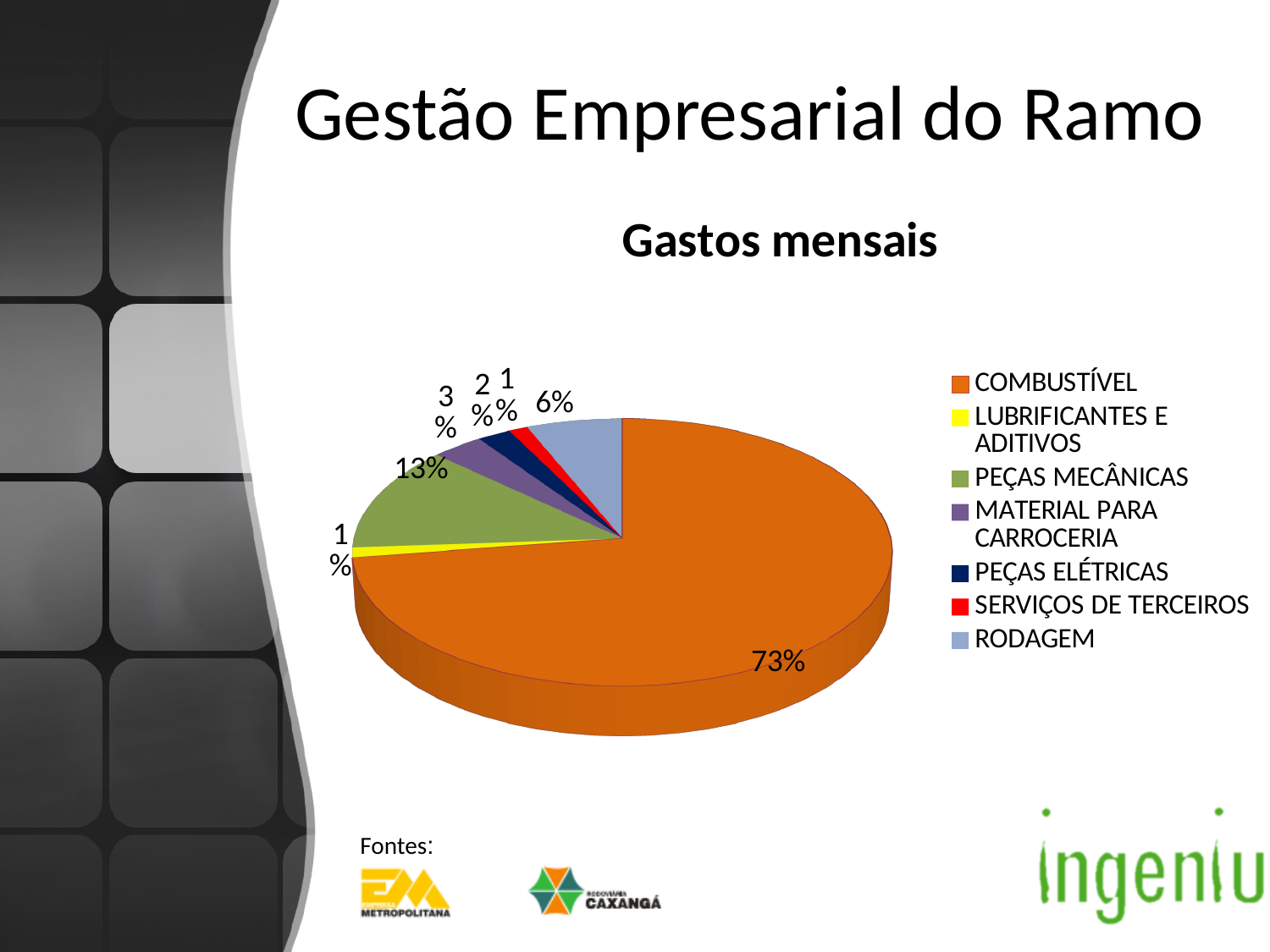
Which is larger, PEÇAS MECÂNICAS or RODAGEM? PEÇAS MECÂNICAS What percentage is shown for RODAGEM? 6% What percentage is shown for PEÇAS ELÉTRICAS? 2% What colour is the COMBUSTÍVEL slice? Orange What share of the pie does COMBUSTÍVEL represent? 73% How many categories does the legend list? 7 What percentage is shown for PEÇAS MECÂNICAS? 13% What is the title of the chart? Gastos mensais What percentage is shown for MATERIAL PARA CARROCERIA? 3% Which category has the largest slice of the pie? COMBUSTÍVEL What type of chart is shown on the slide? Pie chart What is the difference in percentage points between COMBUSTÍVEL and PEÇAS MECÂNICAS? 60